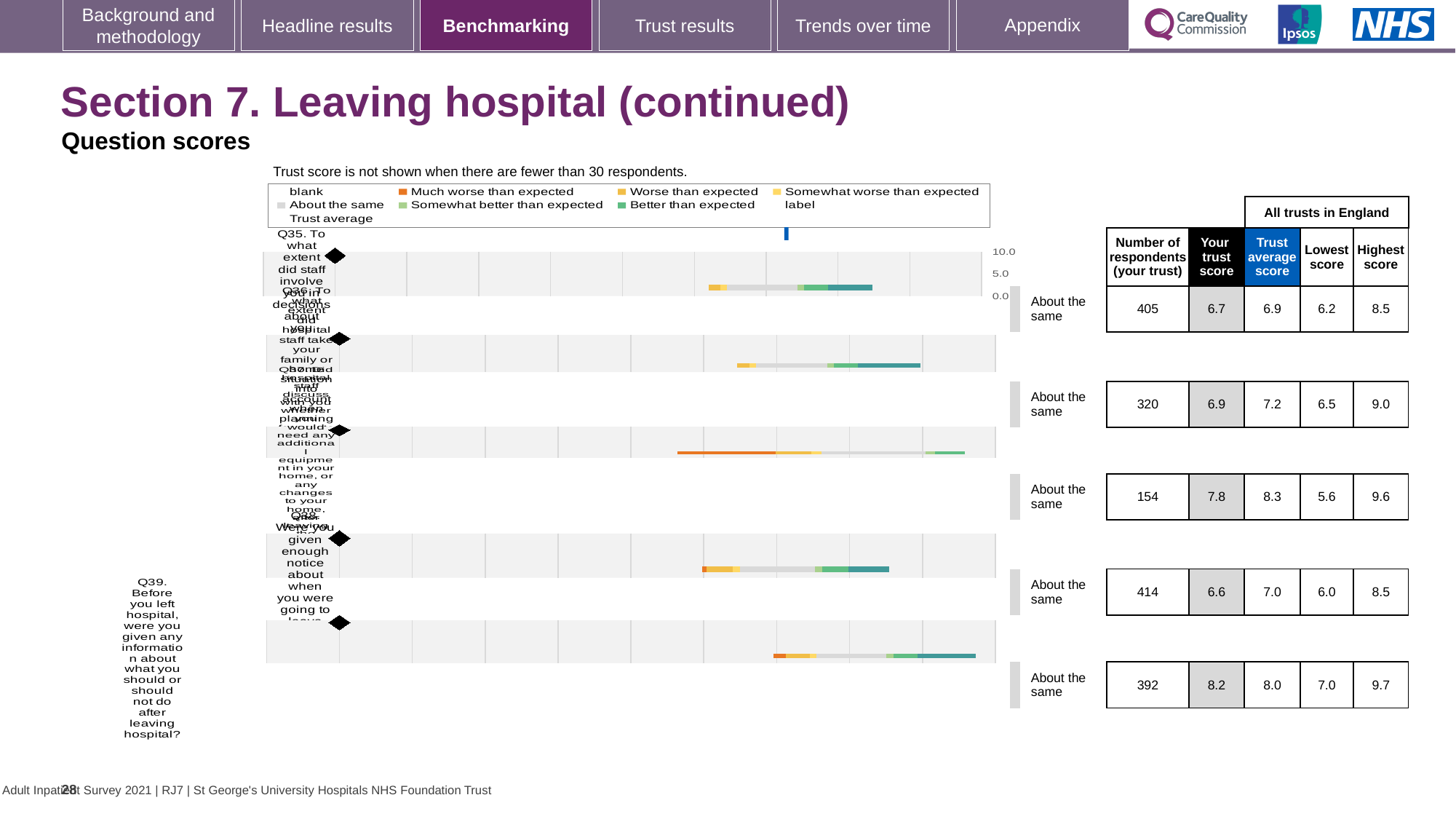
How many questions (rows) are plotted in the benchmarking chart? 5 In the table next to the chart, is the trust score for Q39 (8.2) larger or smaller than the trust average score (8.0)? larger In the table next to the chart, what is the number of respondents for Q39? 392 In the table next to the chart, what is the difference between the highest score (9.7) and the lowest score (7.0) for Q39? 2.7 In the table next to the chart, what is the highest score in England for the third row (154 respondents)? 9.6 In the table next to the chart, which row has the highest 'Your trust score'? Q39 (fifth row), 8.2 What benchmark category is shown for every question in the chart? About the same In the table next to the chart, which row has the lowest 'Your trust score'? Q38 (fourth row), 6.6 In the table next to the chart, what is the trust score for Q39 (information about what you should or should not do after leaving hospital)? 8.2 In the table next to the chart, what is the trust average score for the first row (Q35)? 6.9 What kind of chart is used to show the benchmarking results? bar chart What is the maximum value shown on the chart's score axis? 10.0